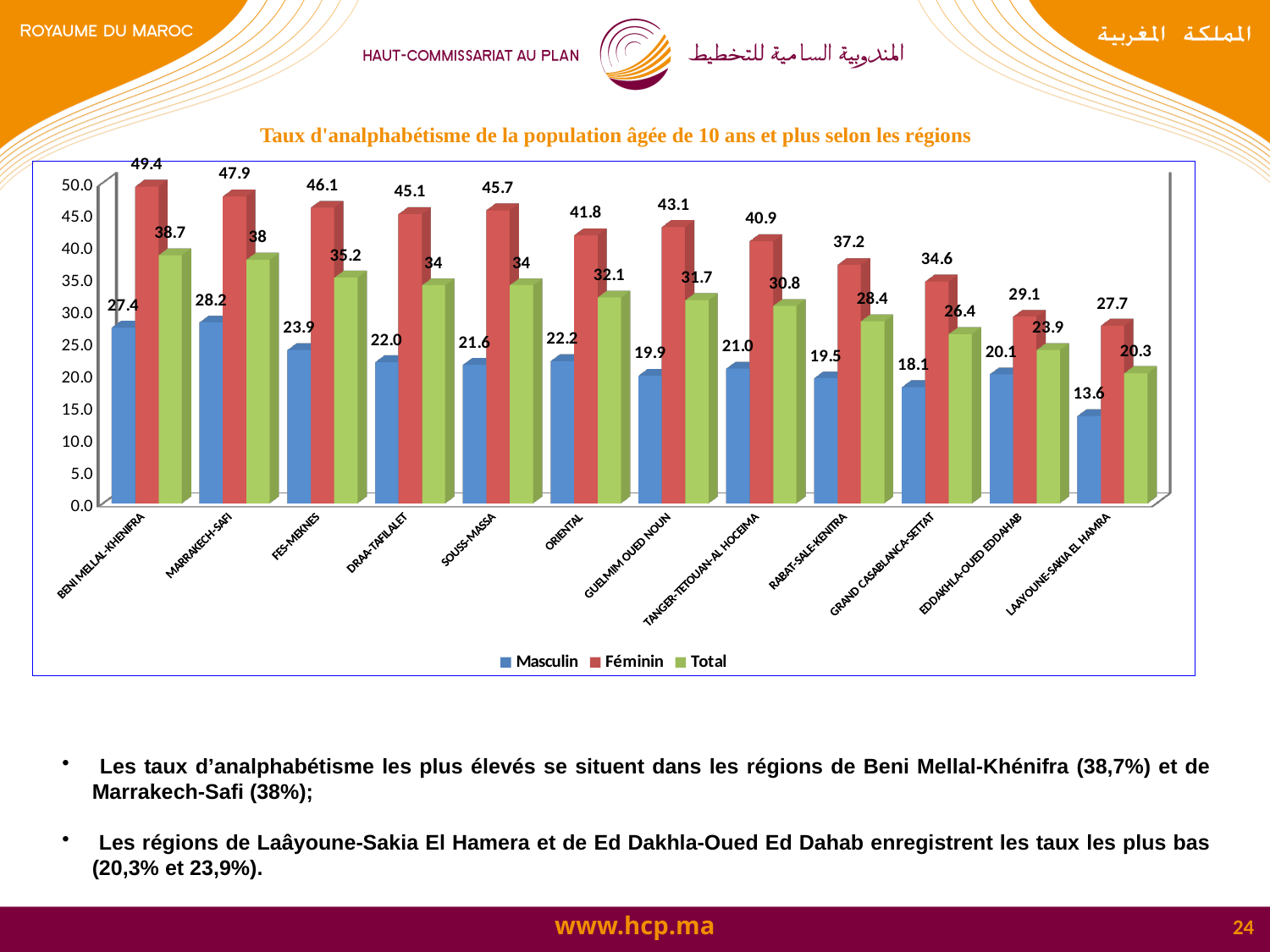
Do the Total values generally rise or fall from left to right along the x axis? fall Which region has the lowest Total value? LAAYOUNE-SAKIA EL HAMRA What is the difference between the Féminin and Masculin values for ORIENTAL? 19.6 Is the Féminin value for RABAT-SALE-KENITRA greater or less than 40.0? less Which is larger, the Masculin value for MARRAKECH-SAFI or the Masculin value for FES-MEKNES? MARRAKECH-SAFI How many regions are shown on the x axis? 12 How many series does the legend list? 3 Which region has the highest Féminin value? BENI MELLAL-KHENIFRA What kind of chart is shown on the slide? bar chart What is the Total value for GRAND CASABLANCA-SETTAT? 26.4 What is the Masculin value for LAAYOUNE-SAKIA EL HAMRA? 13.6 What is the Féminin value for BENI MELLAL-KHENIFRA? 49.4